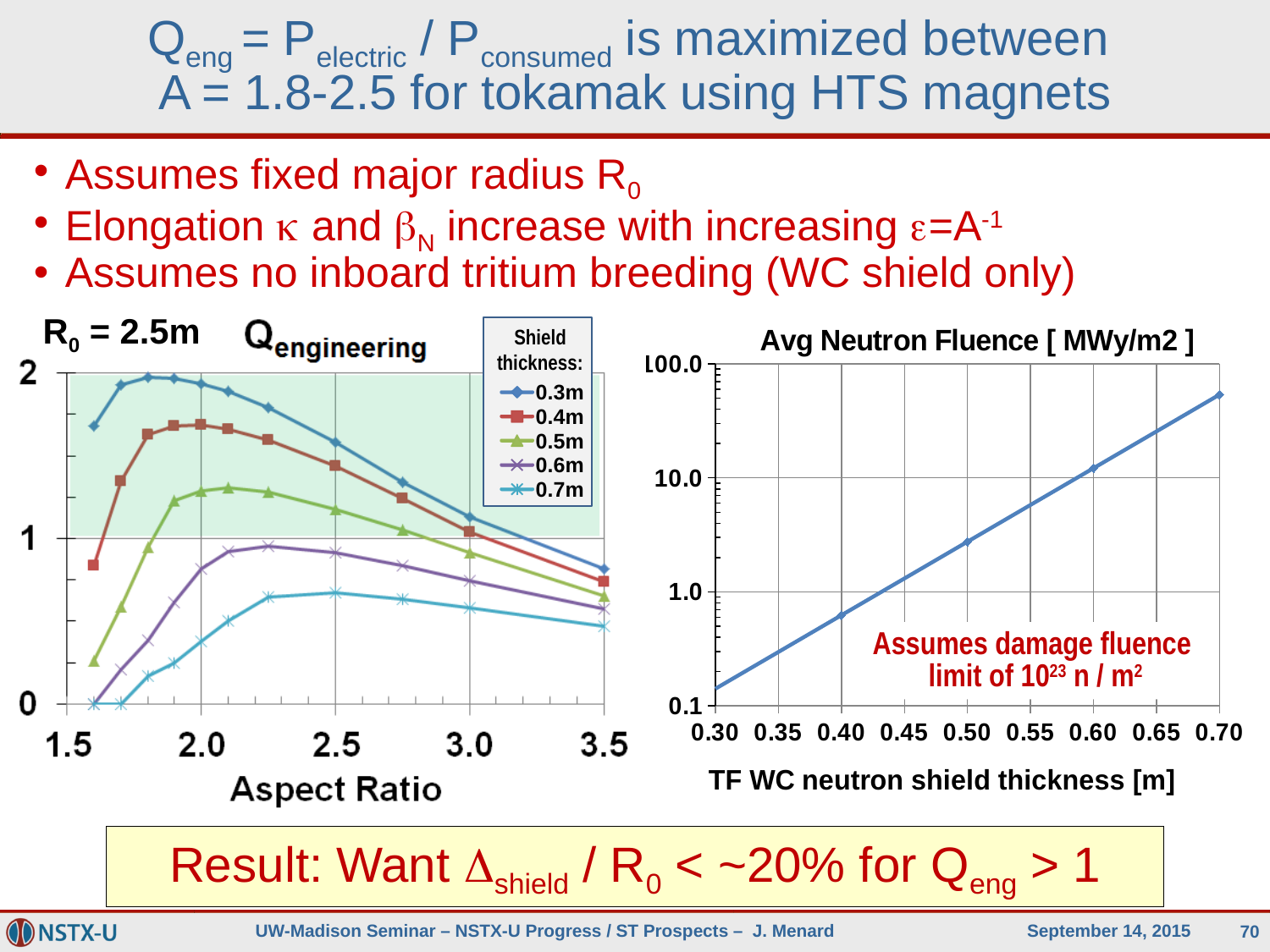
In the Avg Neutron Fluence chart, is the value at a shield thickness of 0.70 m greater or less than 10.0? greater What kind of chart is the Avg Neutron Fluence chart on the right? line chart In the Q_engineering chart, at aspect ratio 2.0, which series has the larger value: 0.3m or 0.6m? 0.3m In the Q_engineering chart, is the value for the 0.7m series at aspect ratio 2.5 greater or less than 1? less In the Avg Neutron Fluence chart, do the values rise or fall as the shield thickness increases from 0.30 to 0.70 m? rise What kind of chart is the Q_engineering chart on the left? line chart In the Q_engineering chart, which shield thickness series has the lowest values across the aspect ratio range? 0.7m In the Q_engineering chart, what shield thickness does the legend give for the top (blue) series? 0.3m In the Avg Neutron Fluence chart, is the value at a shield thickness of 0.30 m greater or less than 1.0? less In the Q_engineering chart, which shield thickness series has the highest values across the aspect ratio range? 0.3m How many series does the legend of the Q_engineering chart list? 5